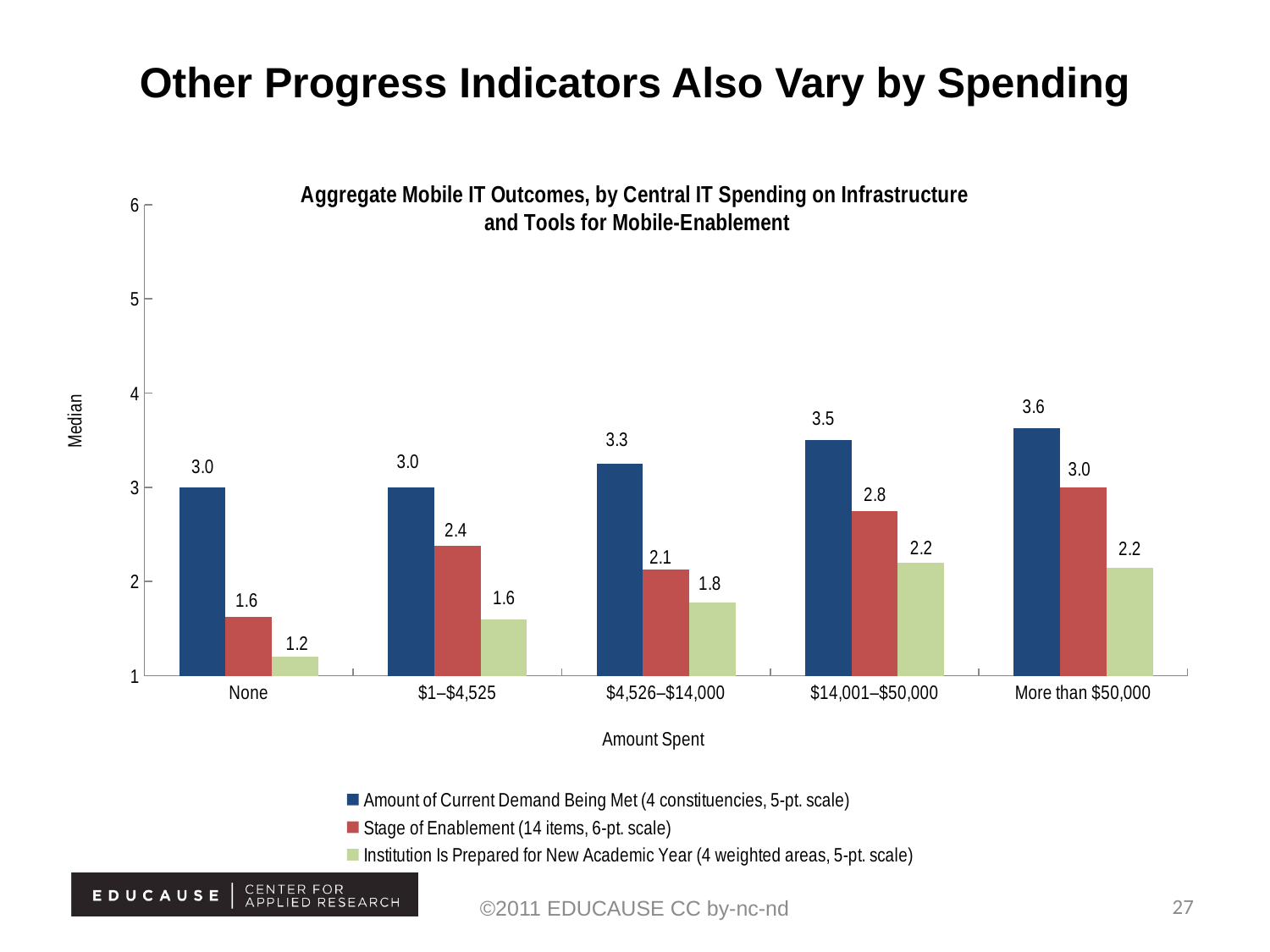
Which spending category has the lowest median for Institution Is Prepared for New Academic Year? None Which is larger in the $4,526–$14,000 category: the Stage of Enablement median or the Institution Is Prepared for New Academic Year median? Stage of Enablement What is the label of the x axis? Amount Spent Which spending category has the highest median for Stage of Enablement? More than $50,000 What kind of chart is shown on the slide? Bar chart How many spending categories are shown on the x axis? 5 What is the median for Stage of Enablement in the $1–$4,525 category? 2.4 How many series does the legend list? 3 What is the median for Amount of Current Demand Being Met in the More than $50,000 category? 3.6 Does the median for Stage of Enablement rise or fall as spending increases from None to More than $50,000? Rise What is the difference between the Amount of Current Demand Being Met median and the Stage of Enablement median in the None category? 1.4 What is the median for Institution Is Prepared for New Academic Year in the None category? 1.2